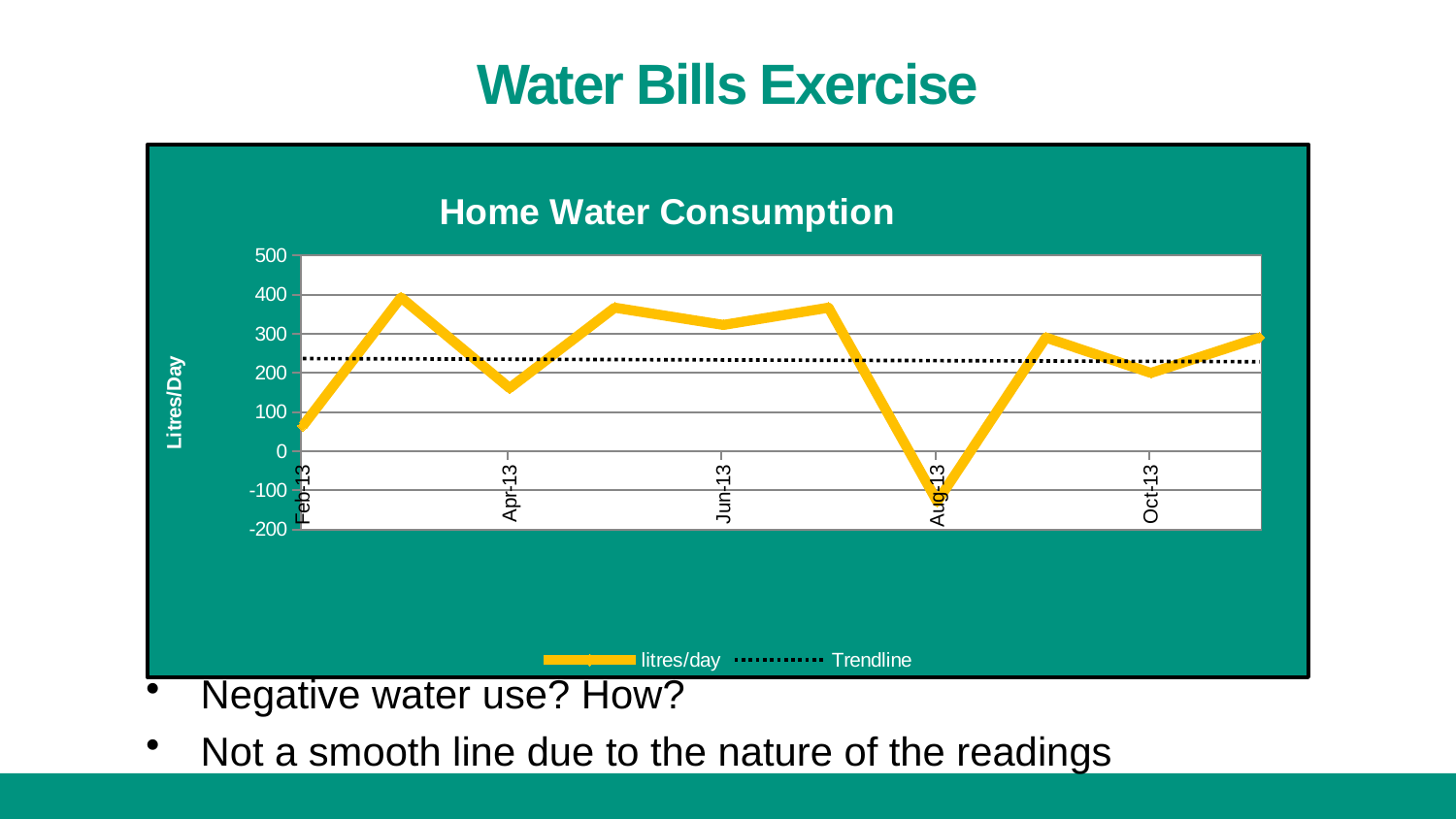
What are the two entries in the chart legend? litres/day and Trendline What is the title of the chart? Home Water Consumption Is the litres/day value for Feb-13 greater or less than 100? less Which month has the lowest litres/day value? Aug-13 Is the litres/day value for Jun-13 greater or less than 300? greater What kind of chart is shown on the slide? Line chart Is the litres/day value for Oct-13 greater or less than 300? less Which has the higher litres/day value, Jun-13 or Apr-13? Jun-13 How many month labels are shown on the x axis? 5 How many series does the legend list? 2